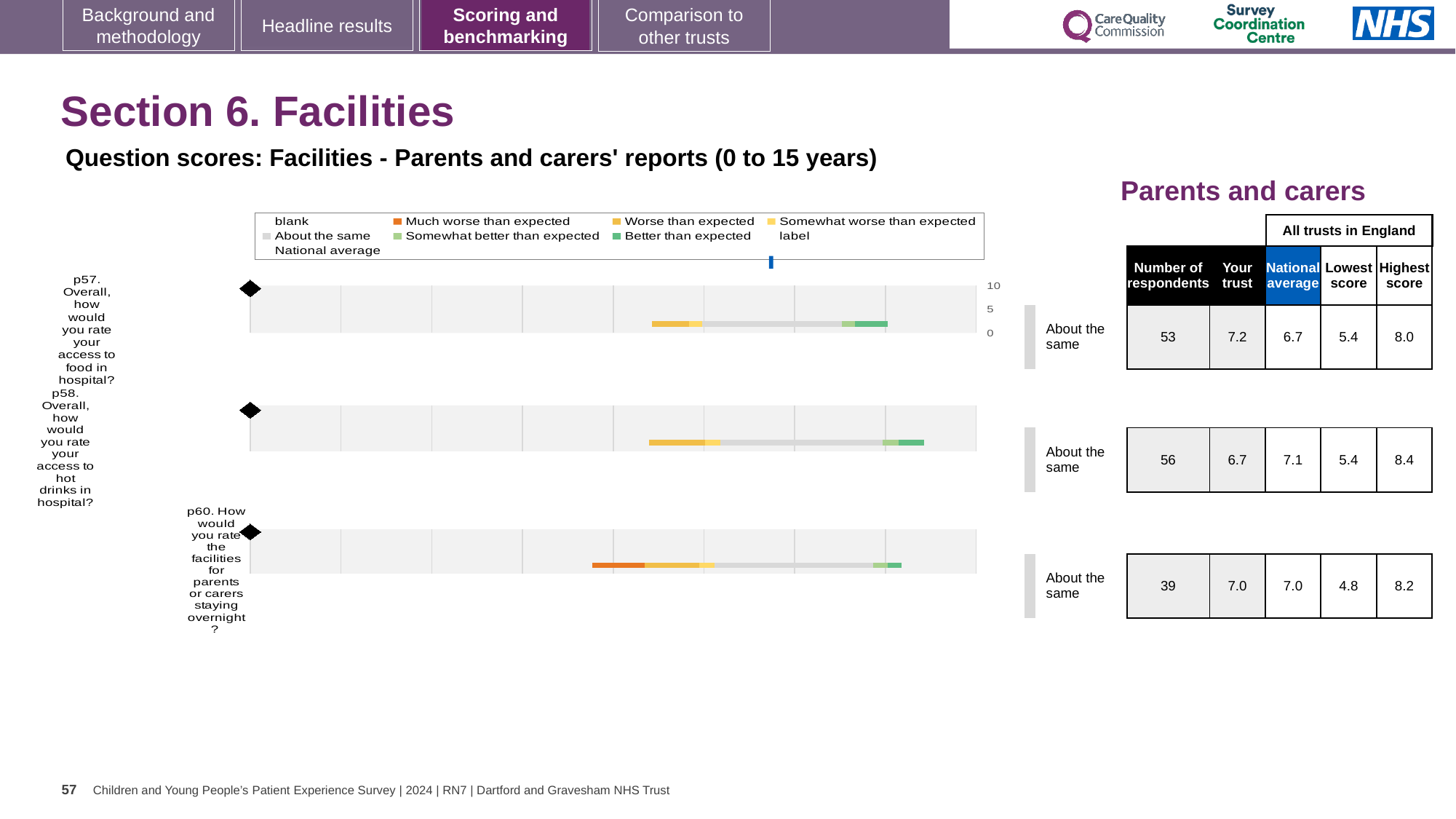
What is the 'Your trust' score for p57 (access to food in hospital)? 7.2 How many questions (rows) are plotted in the chart? 3 Which question has the lowest 'Lowest score' among all trusts in England? p60 How many respondents answered p60 (facilities for parents or carers staying overnight)? 39 What kind of chart is used to show the question scores on this slide? bar chart For p58, which is larger: the 'Your trust' score or the national average? National average What benchmark category is shown for p57? About the same What is the national average score for p58 (access to hot drinks in hospital)? 7.1 Which question has the highest 'Your trust' score? p57 In the chart legend, which colour represents 'Much worse than expected'? orange What is the title above the chart? Question scores: Facilities - Parents and carers' reports (0 to 15 years) What is the difference between the 'Your trust' score and the national average for p57? 0.5